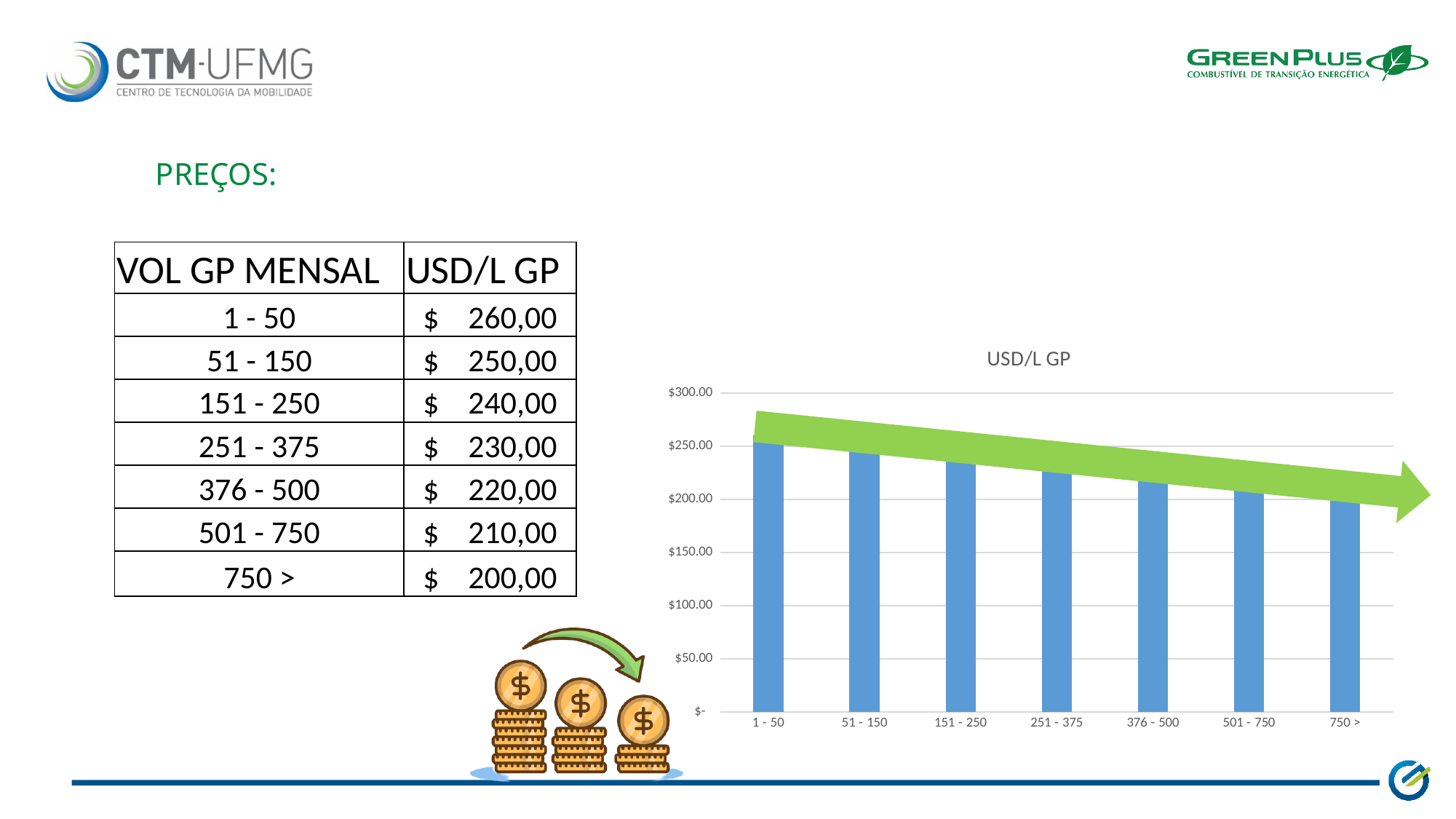
What is the USD/L GP value for the 1 - 50 category? $ 260,00 Is the value for 1 - 50 greater or less than $250.00? greater What is the difference between the USD/L GP value for 1 - 50 and for 750 >? $ 60,00 Do the values in the chart rise or fall from left to right along the x axis? fall What is the title of the chart? USD/L GP Which category has the lowest bar in the chart? 750 > Which is larger, the value for 51 - 150 or the value for 501 - 750? 51 - 150 Is the value for 750 > greater or less than $250.00? less Which category has the highest bar in the chart? 1 - 50 What kind of chart is shown on the slide? bar chart How many categories are shown on the x axis of the chart? 7 Is the value for 376 - 500 greater or less than $200.00? greater